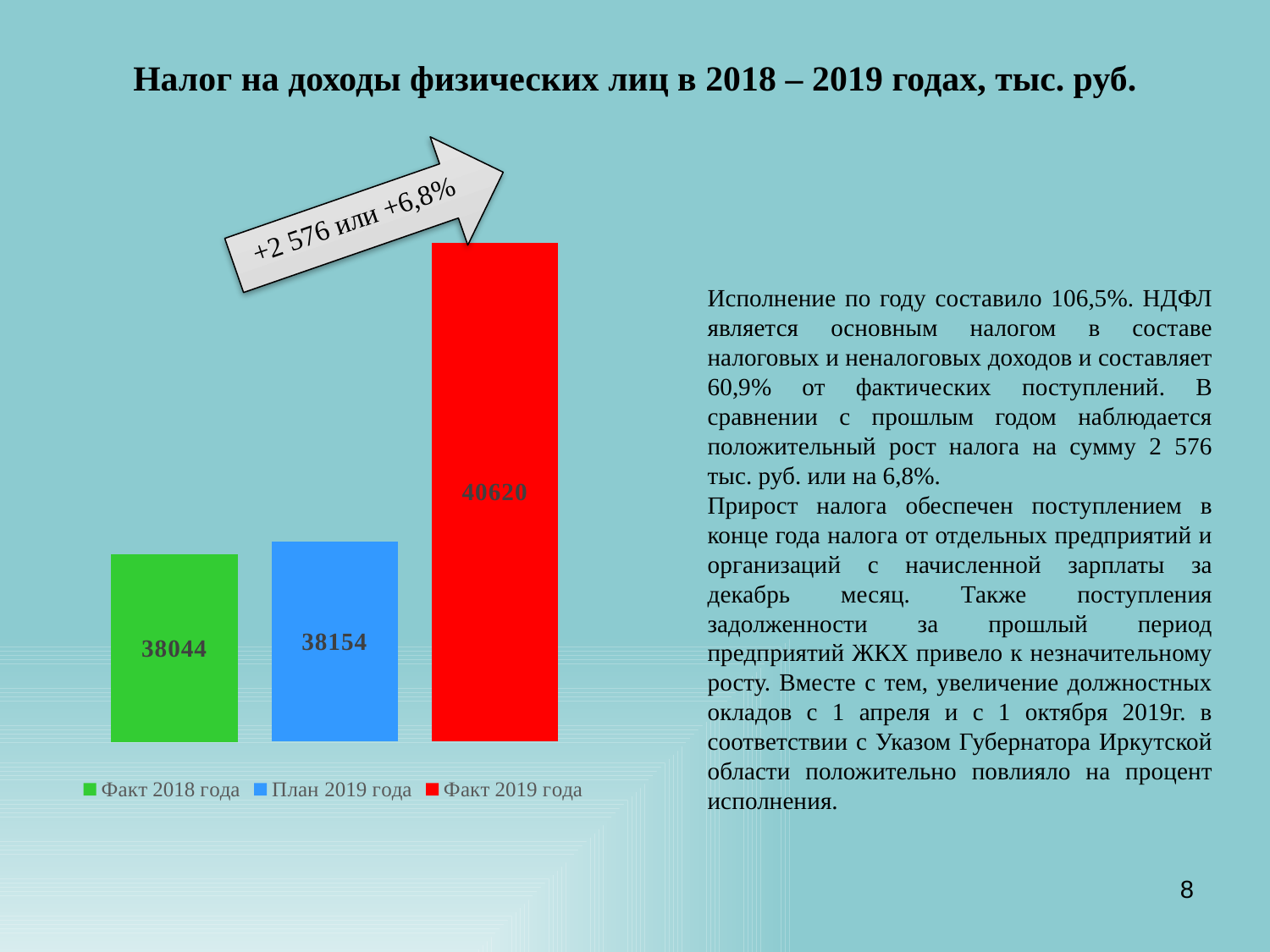
What is the value for Факт 2019 года? 40620 What growth does the arrow annotation on the chart state? +2 576 или +6,8% What kind of chart is shown on the slide? bar chart What is the difference between Факт 2019 года and Факт 2018 года? 2576 What is the value for План 2019 года? 38154 Which is larger, Факт 2019 года or План 2019 года? Факт 2019 года Which series has the highest value? Факт 2019 года What is the difference between Факт 2019 года and План 2019 года? 2466 What is the value for Факт 2018 года? 38044 How many series does the legend list? 3 Which series has the lowest value? Факт 2018 года What colour is the bar for Факт 2019 года? red